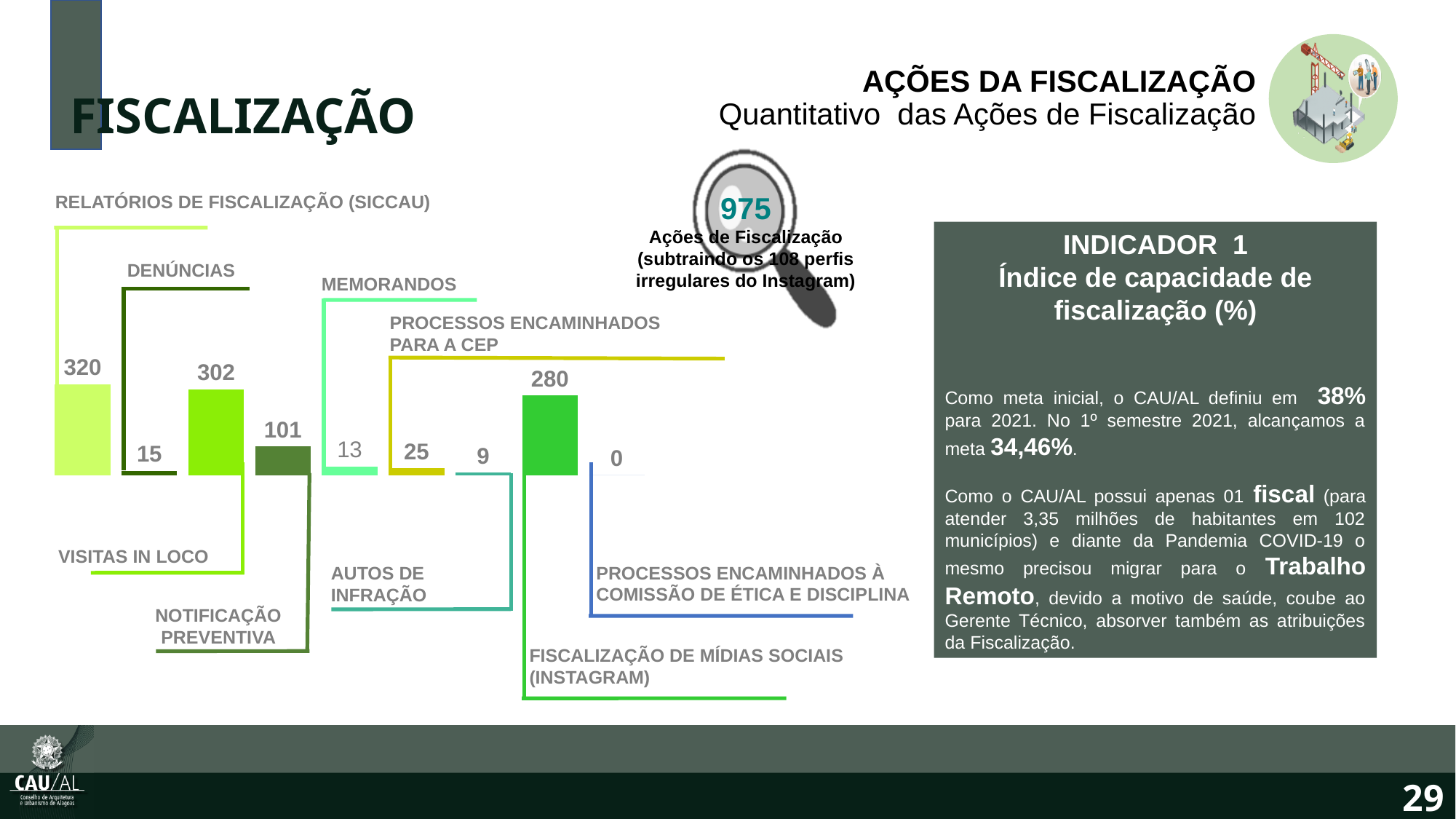
What is the value for Fiscalização de Mídias Sociais (Instagram)? 280 What is the difference between Processos Encaminhados para a CEP and Autos de Infração? 16 What is the value for Processos Encaminhados à Comissão de Ética e Disciplina? 0 What is the value for Relatórios de Fiscalização (SICCAU)? 320 Which category has the lowest value? Processos Encaminhados à Comissão de Ética e Disciplina What is the value for Visitas in Loco? 302 What is the difference between Relatórios de Fiscalização (SICCAU) and Visitas in Loco? 18 What kind of chart is shown on the slide? Bar chart Which is larger, Denúncias or Memorandos? Denúncias Which category has the highest value? Relatórios de Fiscalização (SICCAU) What is the value for Notificação Preventiva? 101 How many categories are shown in the chart? 9